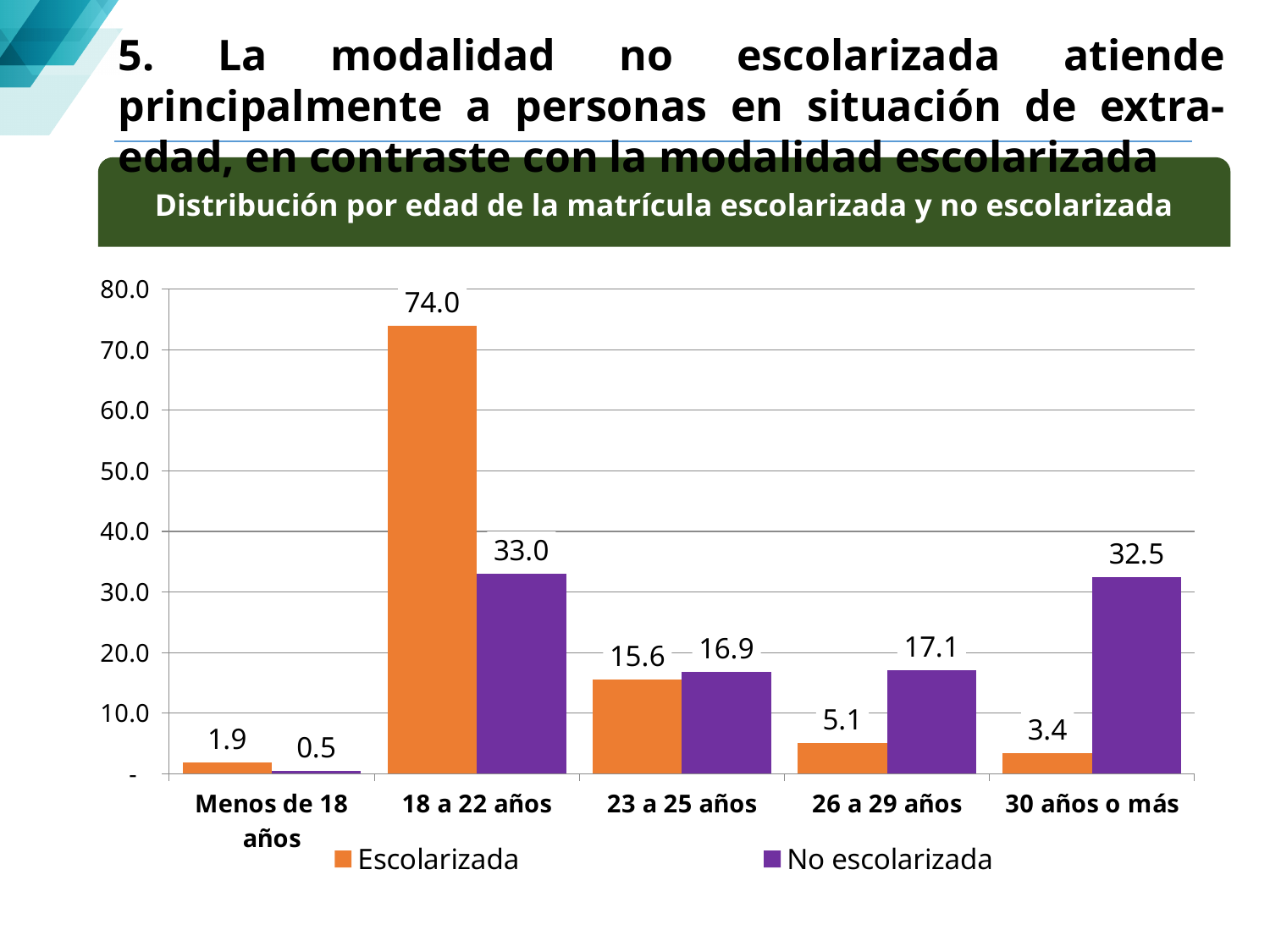
For 30 años o más, which series has the larger value, Escolarizada or No escolarizada? No escolarizada Is the No escolarizada value for 18 a 22 años greater or less than 30.0? greater What is the difference between the Escolarizada and No escolarizada values for 18 a 22 años? 41.0 How many age groups are shown on the x axis? 5 Which age group has the lowest No escolarizada value? Menos de 18 años What is the No escolarizada value for Menos de 18 años? 0.5 How many series does the legend list? 2 What colour represents the Escolarizada series? Orange What kind of chart is shown on the slide? Bar chart What is the No escolarizada value for 30 años o más? 32.5 Which age group has the highest Escolarizada value? 18 a 22 años What is the Escolarizada value for 18 a 22 años? 74.0